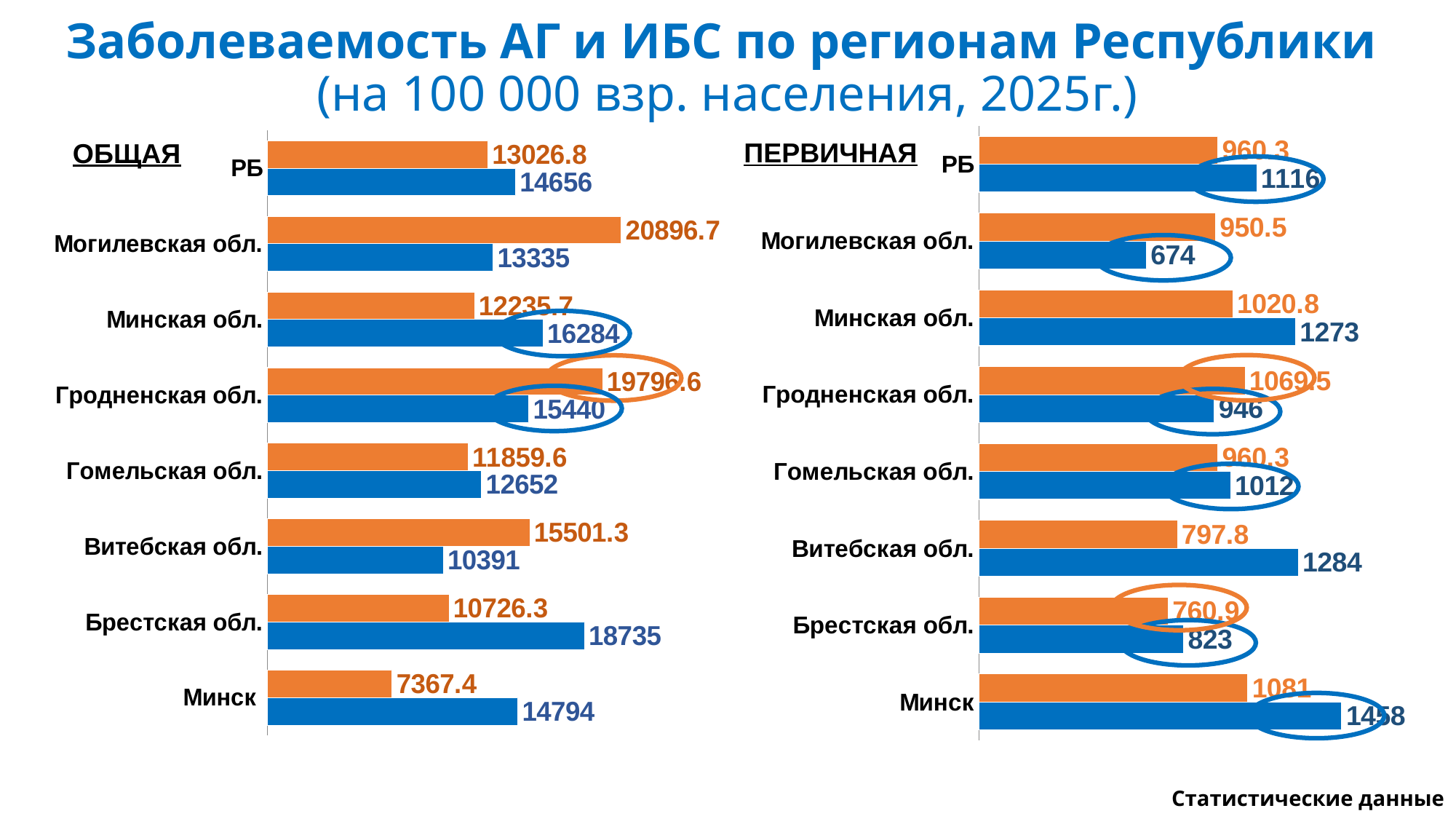
On the ОБЩАЯ chart, what is the value of the blue bar for Брестская обл.? 18735 On the ПЕРВИЧНАЯ chart, what is the value of the orange bar for Витебская обл.? 797.8 What type of chart is the ПЕРВИЧНАЯ chart? bar chart How many categories are shown on the ОБЩАЯ chart? 8 On the ОБЩАЯ chart, what is the value of the orange bar for Могилевская обл.? 20896.7 On the ОБЩАЯ chart, which category has the lowest orange bar value? Минск On the ПЕРВИЧНАЯ chart, what is the value of the blue bar for Минск? 1458 On the ПЕРВИЧНАЯ chart, which category has the lowest blue bar value? Могилевская обл. On the ОБЩАЯ chart, what is the difference between the blue and orange bar values for Минск? 7426.6 On the ПЕРВИЧНАЯ chart, which is larger for Витебская обл., the orange bar or the blue bar? the blue bar On the ОБЩАЯ chart, which region has the highest orange bar value? Могилевская обл. On the ПЕРВИЧНАЯ chart, which category has the highest blue bar value? Минск